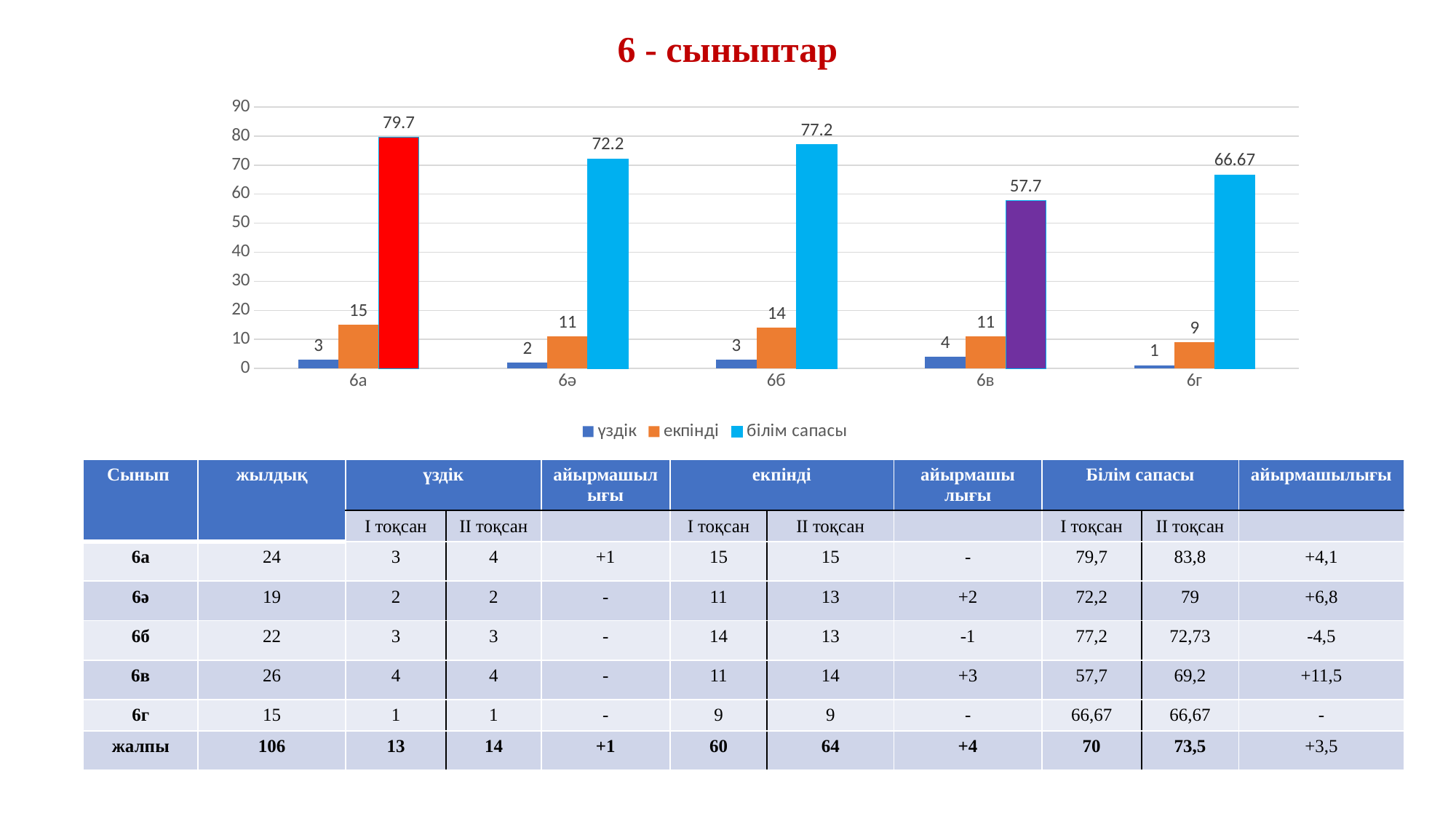
How many classes (categories) are shown on the x axis of the chart? 5 Which class has the lowest үздік value? 6г What is the value of білім сапасы for 6а? 79.7 What is the value of үздік for 6в? 4 What is the value of білім сапасы for 6г? 66.67 Which class has the lowest білім сапасы value? 6в Which class has the highest білім сапасы value? 6а What type of chart is shown on the slide? bar chart Which is larger, the екпінді value for 6а or for 6г? 6а What is the value of екпінді for 6б? 14 What is the difference between the білім сапасы values for 6а and 6ә? 7.5 How many series does the chart legend list? 3